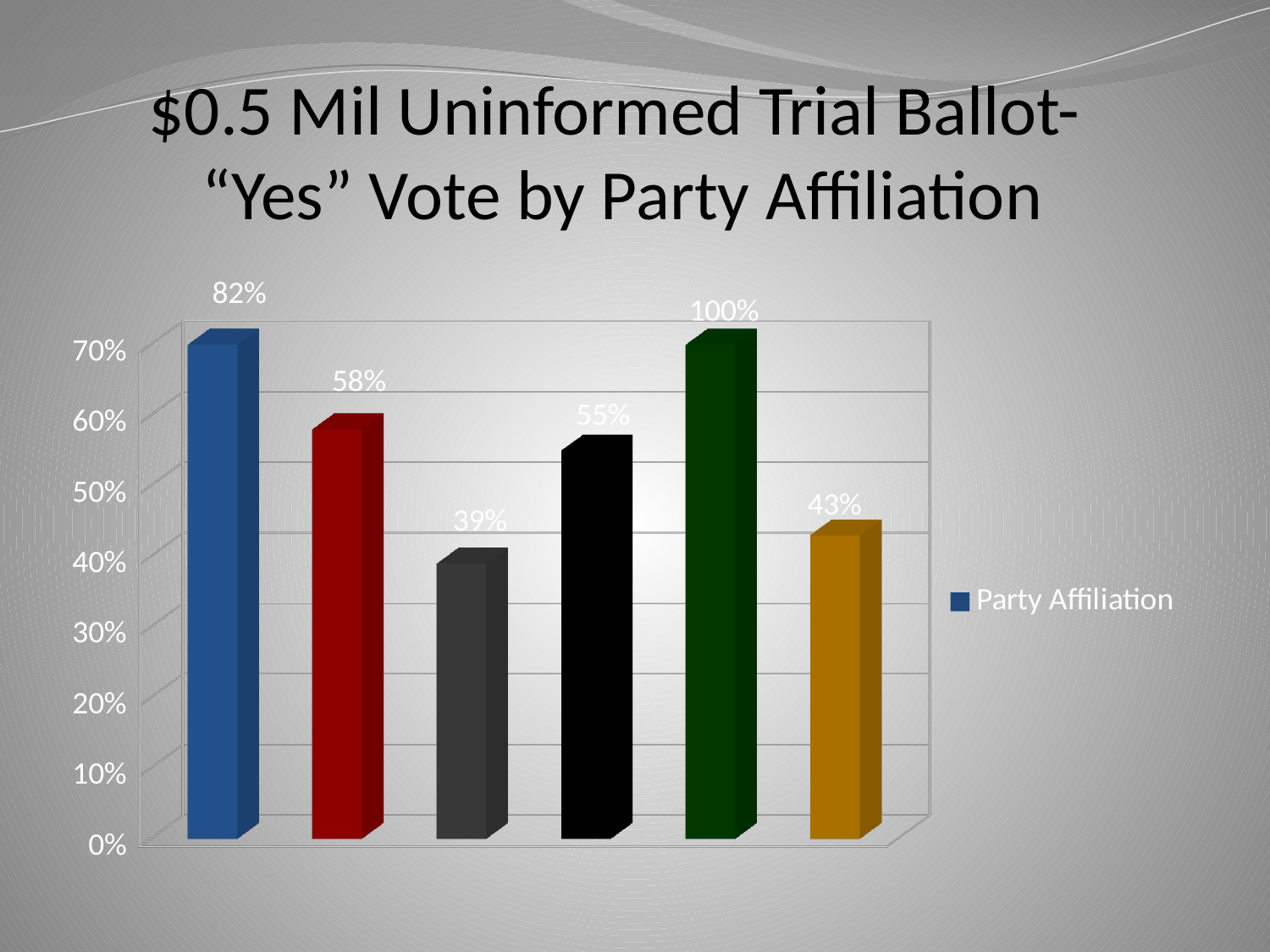
What is the difference between the data labels of the first (blue) bar and the last (gold) bar? 39% How many bars are plotted in the chart? 6 What is the legend entry shown on the chart? Party Affiliation What is the data label on the third (grey) bar? 39% Which bar has the lowest data label? the third (grey) bar, 39% What is the data label on the fifth (green) bar? 100% Which bar has the highest data label? the fifth (green) bar, 100% What is the data label on the second (red) bar? 58% What is the data label on the first (blue) bar? 82% Which is larger, the data label on the fourth (black) bar or the second (red) bar? the second (red) bar, 58% How many series does the legend list? 1 What kind of chart is shown on the slide? bar chart